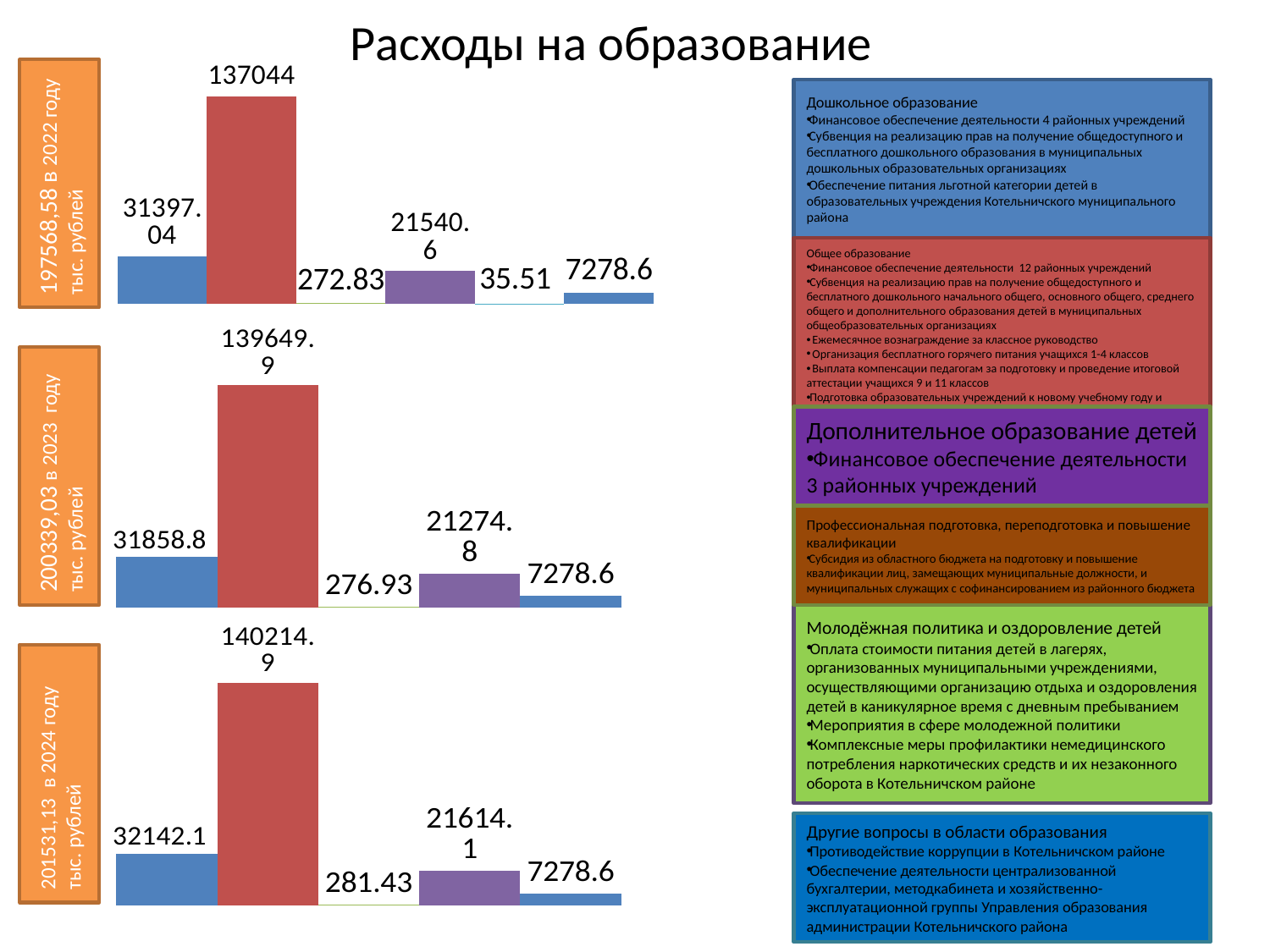
In the middle chart (2023), what is the value of the smallest bar? 276.93 In the bottom chart (2024), what is the difference between the first blue bar (32142.1) and the purple bar (21614.1)? 10528 What kind of chart is used for the 2022 data (top chart)? bar chart How many bars are shown in the bottom chart (2024)? 5 In the bottom chart (2024), what is the value of the red bar? 140214.9 In the middle chart (2023), what is the value of the purple bar? 21274.8 In the bottom chart (2024), which is larger: the blue bar on the left (32142.1) or the purple bar (21614.1)? 32142.1 In the top chart (2022), which bar has the lowest value? 35.51 In the top chart (2022), what is the value of the first (blue) bar? 31397.04 How many bars are shown in the top chart (2022)? 6 What is the title of the slide's charts? Расходы на образование In the top chart (2022), what is the value of the tallest red bar? 137044